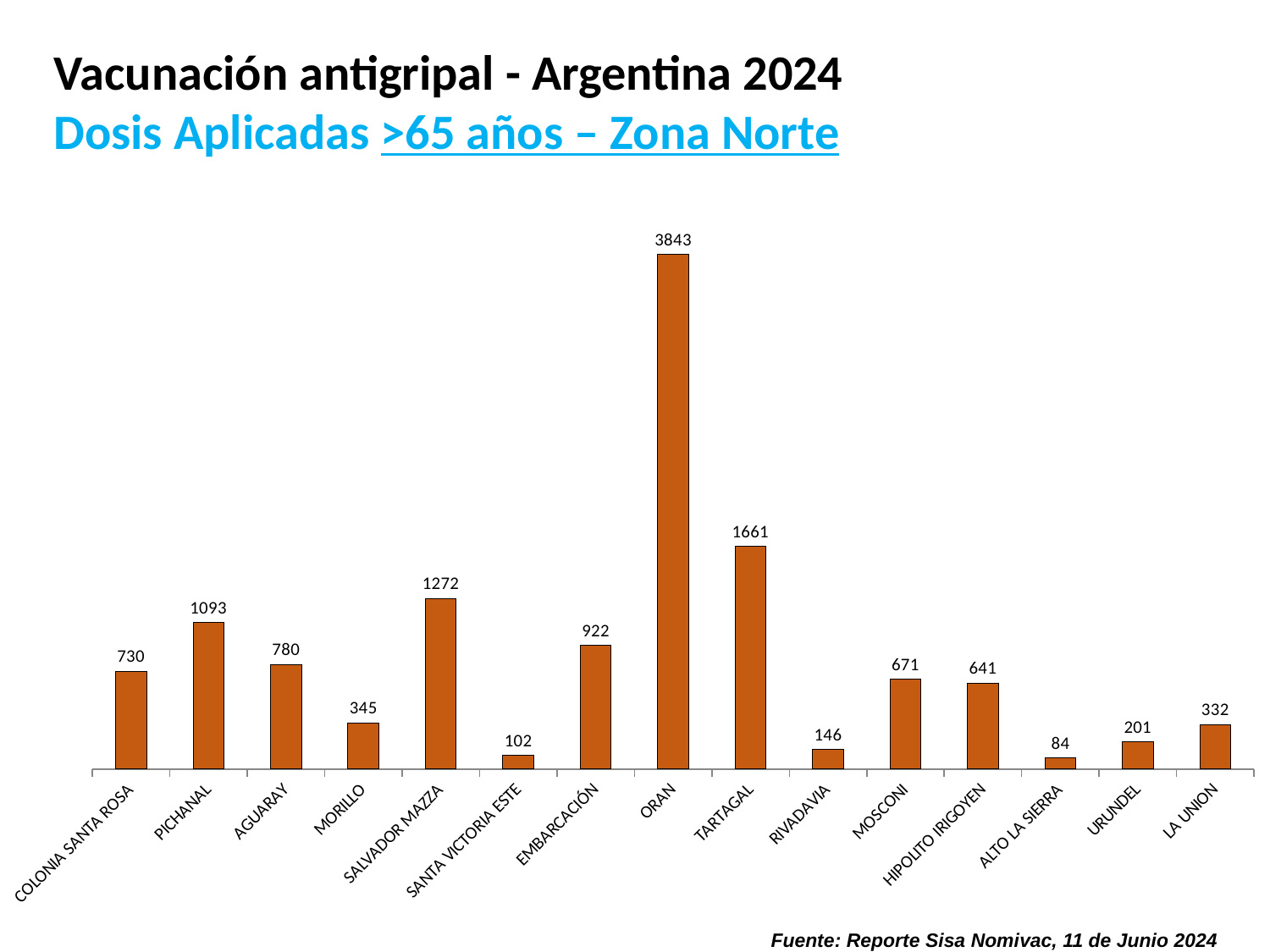
What is the value for ORAN? 3843 What is the value for SANTA VICTORIA ESTE? 102 Which is larger, the value for MOSCONI or the value for HIPOLITO IRIGOYEN? MOSCONI How many doses are shown for SALVADOR MAZZA? 1272 How many categories are shown on the x axis? 15 What is the value for HIPOLITO IRIGOYEN? 641 What is the difference between the values for PICHANAL and AGUARAY? 313 Which category has the highest value? ORAN What is the difference between the values for ORAN and TARTAGAL? 2182 Which category has the lowest value? ALTO LA SIERRA What colour are the bars in the chart? Orange What kind of chart is shown on the slide? Bar chart